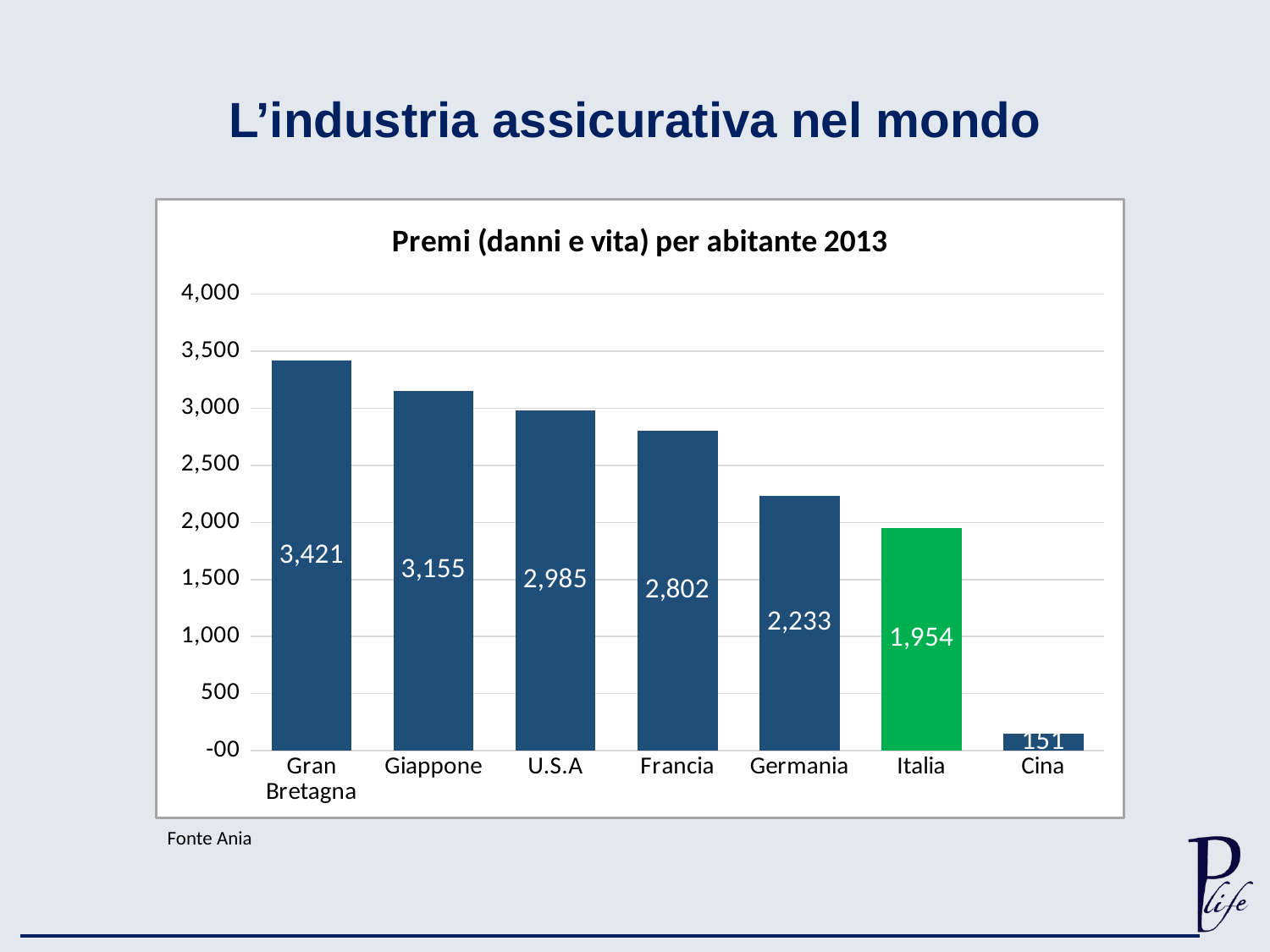
What is the difference between the values for Gran Bretagna and Italia? 1,467 What is the value for Cina? 151 Is the value for Germania greater or less than 2,000? greater What kind of chart is shown on the slide? bar chart Which bar is coloured green rather than blue? Italia What is the value for Italia? 1,954 Which country has the highest value? Gran Bretagna Which is larger, the value for Francia or the value for Germania? Francia What is the value for Gran Bretagna? 3,421 What is the difference between the values for Giappone and U.S.A? 170 How many countries are shown in the chart? 7 Which country has the lowest value? Cina